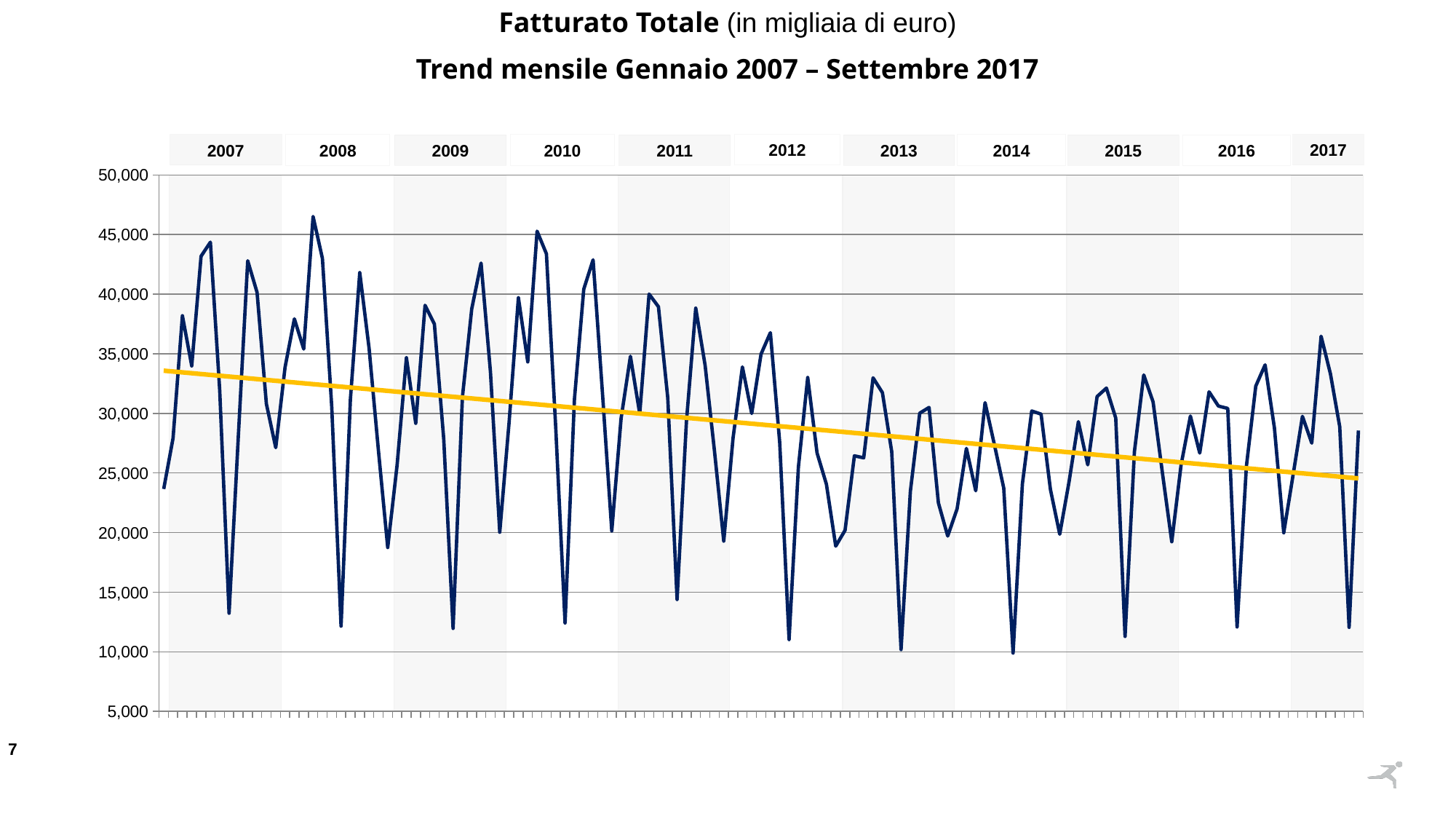
Is the lowest dip of the monthly line in 2007 greater or less than 15,000? less Is the lowest dip of the monthly line in 2014 greater or less than 15,000? less In which year does the monthly line reach its lowest point? 2014 Is the highest peak of the monthly line in 2016 greater or less than 40,000? less What kind of chart is shown on the slide? line chart How many years are labelled along the top of the chart? 11 What is the title of the chart? Fatturato Totale (in migliaia di euro) – Trend mensile Gennaio 2007 – Settembre 2017 What is the highest value shown on the vertical axis? 50,000 Does the yellow trend line rise or fall from 2007 to 2017? fall